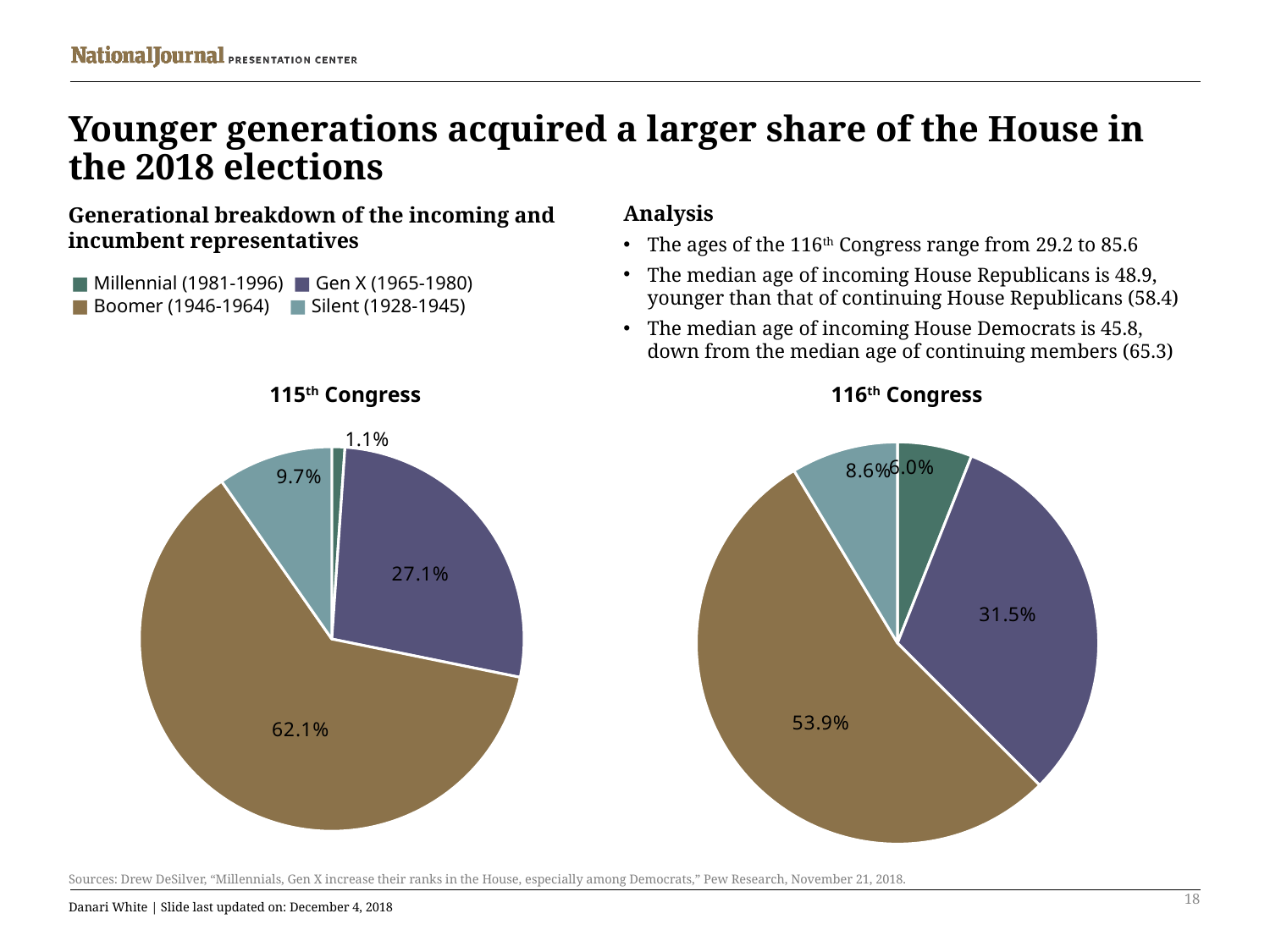
In the 115th Congress chart, which generation has the smallest share? Millennial (1981-1996) In the 116th Congress chart, which is larger: the Silent share or the Millennial share? Silent (1928-1945) In the 116th Congress chart, what share of the House is Silent (1928-1945)? 8.6% What type of chart is used to show the 115th Congress generational breakdown? Pie chart In the 115th Congress chart, what share of the House is Millennial (1981-1996)? 1.1% In the 115th Congress chart, what share of the House is Boomer (1946-1964)? 62.1% How many slices does the 116th Congress pie chart have? 4 How many generations does the legend list? 4 In the 116th Congress chart, which generation has the largest share? Boomer (1946-1964) What is the difference between the Gen X share in the 116th Congress chart and the Gen X share in the 115th Congress chart? 4.4 percentage points What is the difference between the Boomer share in the 115th Congress chart and the Boomer share in the 116th Congress chart? 8.2 percentage points In the 116th Congress chart, what share of the House is Gen X (1965-1980)? 31.5%